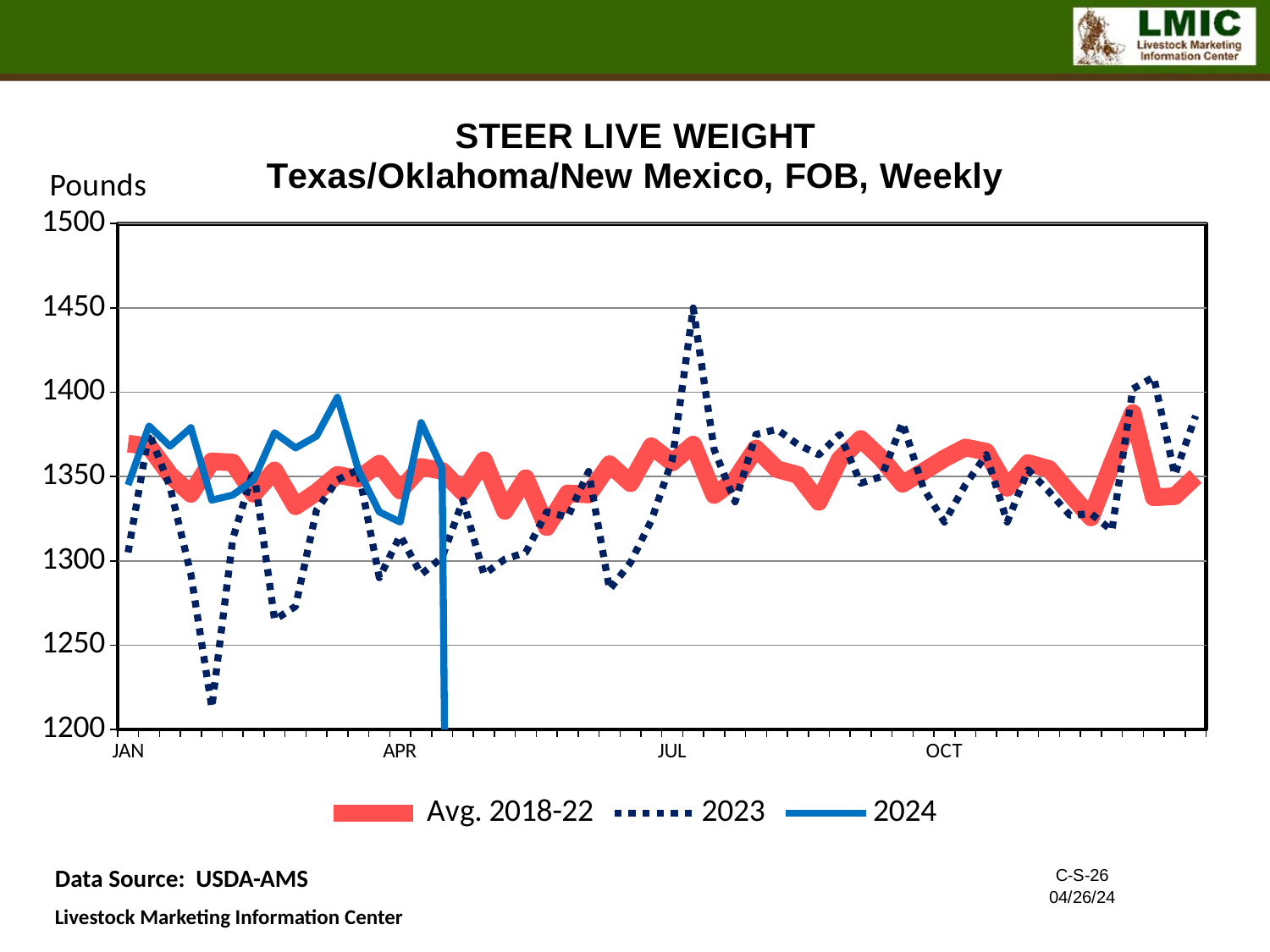
Is the Avg. 2018-22 value at the start of January greater or less than 1350? greater Is the peak value of the 2023 series in early July greater or less than 1400? greater Is the peak value of the 2024 series in late March greater or less than 1350? greater Which series reaches the highest value on the chart? 2023 How many series does the legend list? 3 How many month labels are shown on the x axis? 4 What is the title of the chart? STEER LIVE WEIGHT Texas/Oklahoma/New Mexico, FOB, Weekly What kind of chart is shown on the slide? Line chart At the start of January, which series has the larger value: Avg. 2018-22 or 2023? Avg. 2018-22 What unit is shown on the y axis of the chart? Pounds